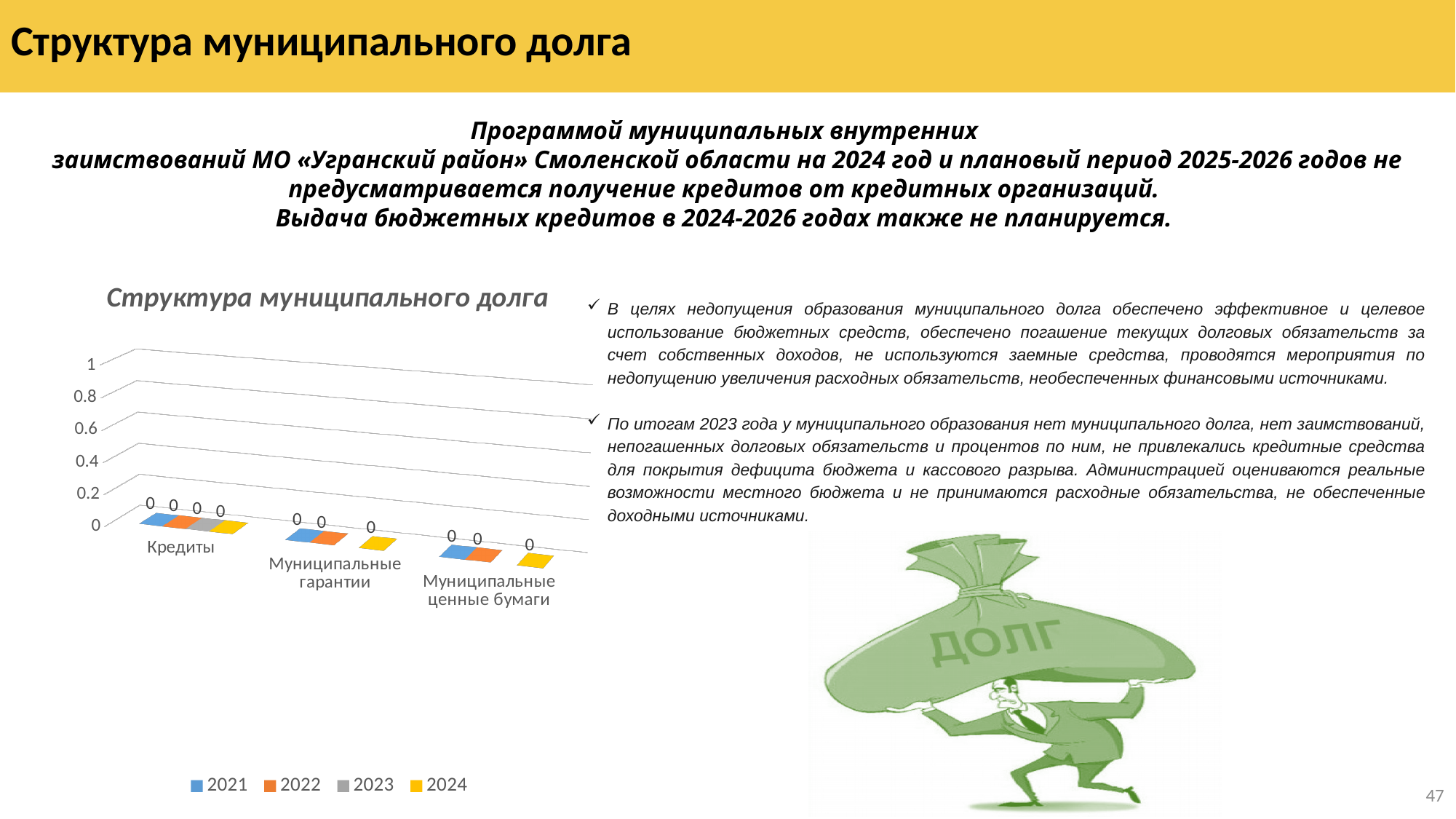
What is the title of the chart on the slide? Структура муниципального долга What kind of chart is shown on the slide? bar chart What is the value for Кредиты in 2021? 0 What is the value for Муниципальные гарантии in 2022? 0 What is the difference between the 2021 value for Кредиты and the 2021 value for Муниципальные гарантии? 0 Is the value for Кредиты in 2022 greater or less than 0.2? less How many categories are shown on the x axis of the chart? 3 What is the value for Кредиты in 2024? 0 Do the values for Кредиты rise, fall, or stay the same from 2021 to 2024? stay the same Which colour represents the 2024 series in the chart legend? yellow What is the value for Муниципальные ценные бумаги in 2024? 0 How many series does the chart legend list? 4